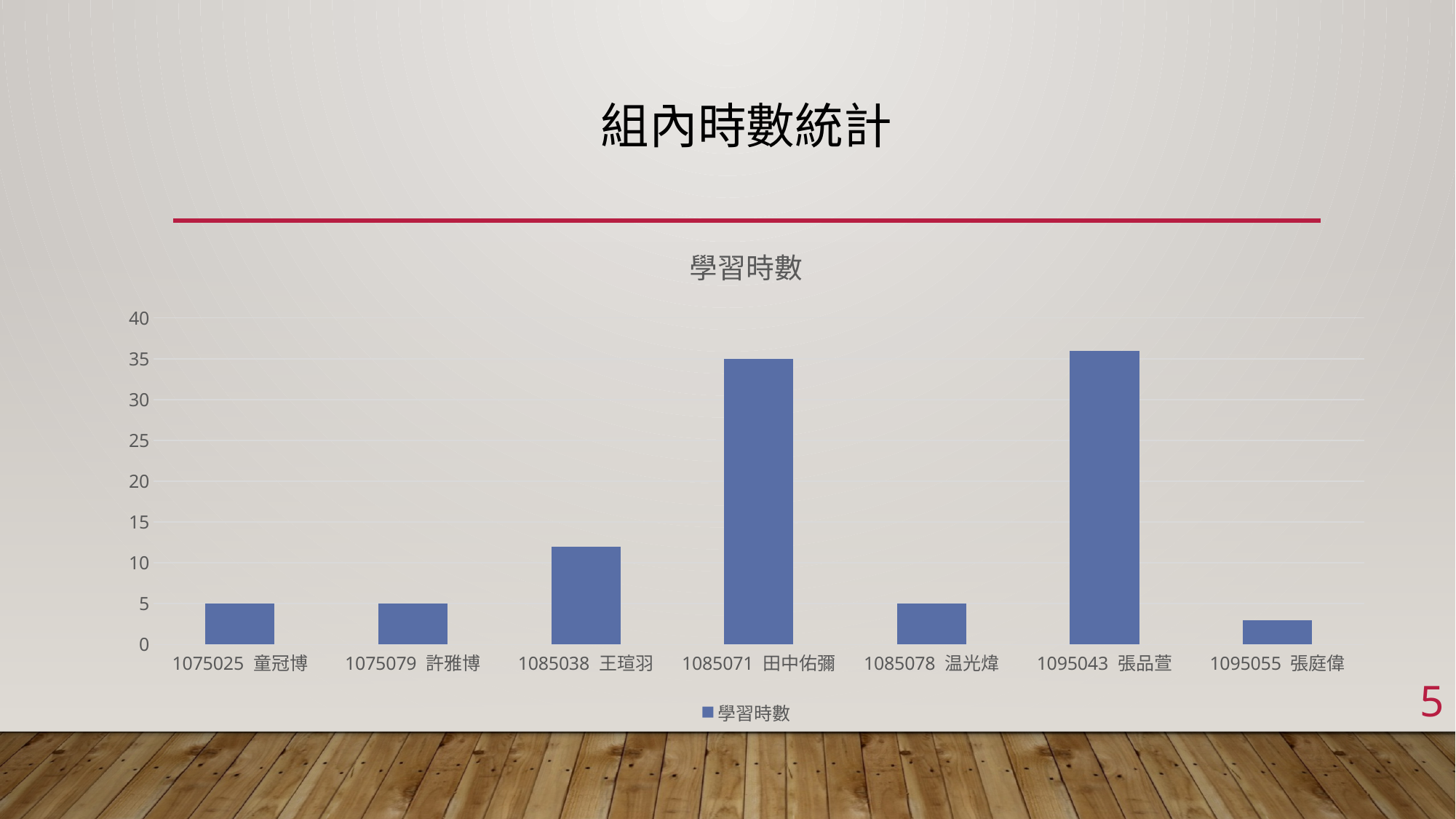
What kind of chart is shown? bar chart How many categories are shown on the x axis? 7 Which category has the lowest value? 1095055 張庭偉 How many series does the legend list? 1 Is the value for 1095043 張品萱 greater or less than 30? greater Which is larger, the value for 1085038 王瑄羽 or the value for 1075079 許雅博? 1085038 王瑄羽 Is the value for 1095055 張庭偉 greater or less than 5? less Is the value for 1085038 王瑄羽 greater or less than 10? greater What is the title of the chart? 學習時數 What is the value for 1085071 田中佑彌? 35 What is the value for 1085078 温光煒? 5 What is the value for 1075025 童冠博? 5